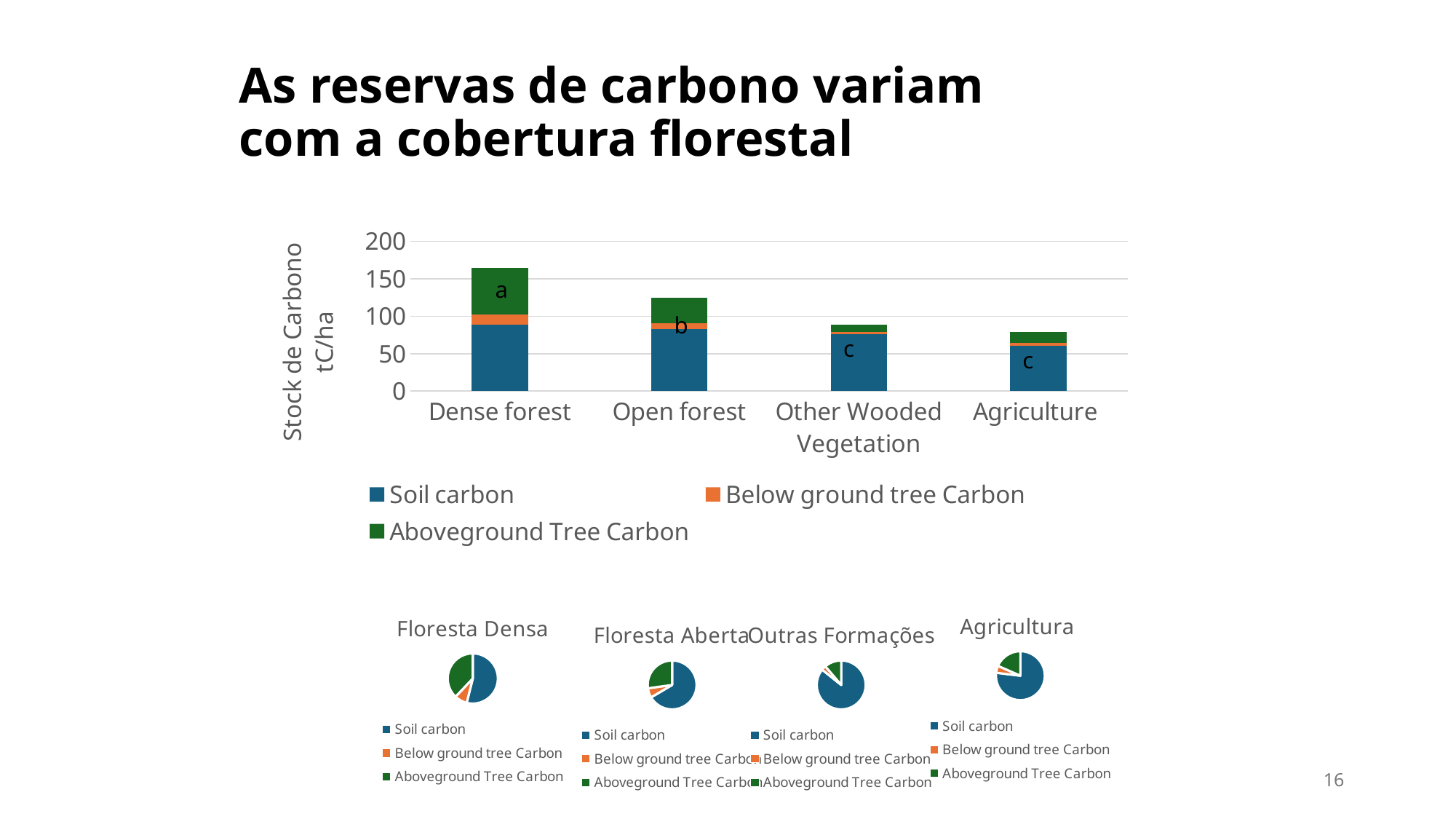
In the stacked bar chart, which has a larger total carbon stock, Dense forest or Open forest? Dense forest What kind of chart is the large chart at the top of the slide? Stacked bar chart In the stacked bar chart, is the total carbon stock for Open forest greater or less than 100? greater In the stacked bar chart, is the total carbon stock for Dense forest greater or less than 150? greater How many series does the legend of the stacked bar chart list? 3 In the stacked bar chart, which category has the lowest total carbon stock? Agriculture In the stacked bar chart, which category has the highest total carbon stock? Dense forest What is the y-axis title of the stacked bar chart? Stock de Carbono tC/ha In the stacked bar chart, do the total carbon stocks rise or fall from Dense forest to Agriculture along the x axis? Fall In the stacked bar chart, is the total carbon stock for Agriculture greater or less than 100? less How many categories are shown on the x axis of the stacked bar chart? 4